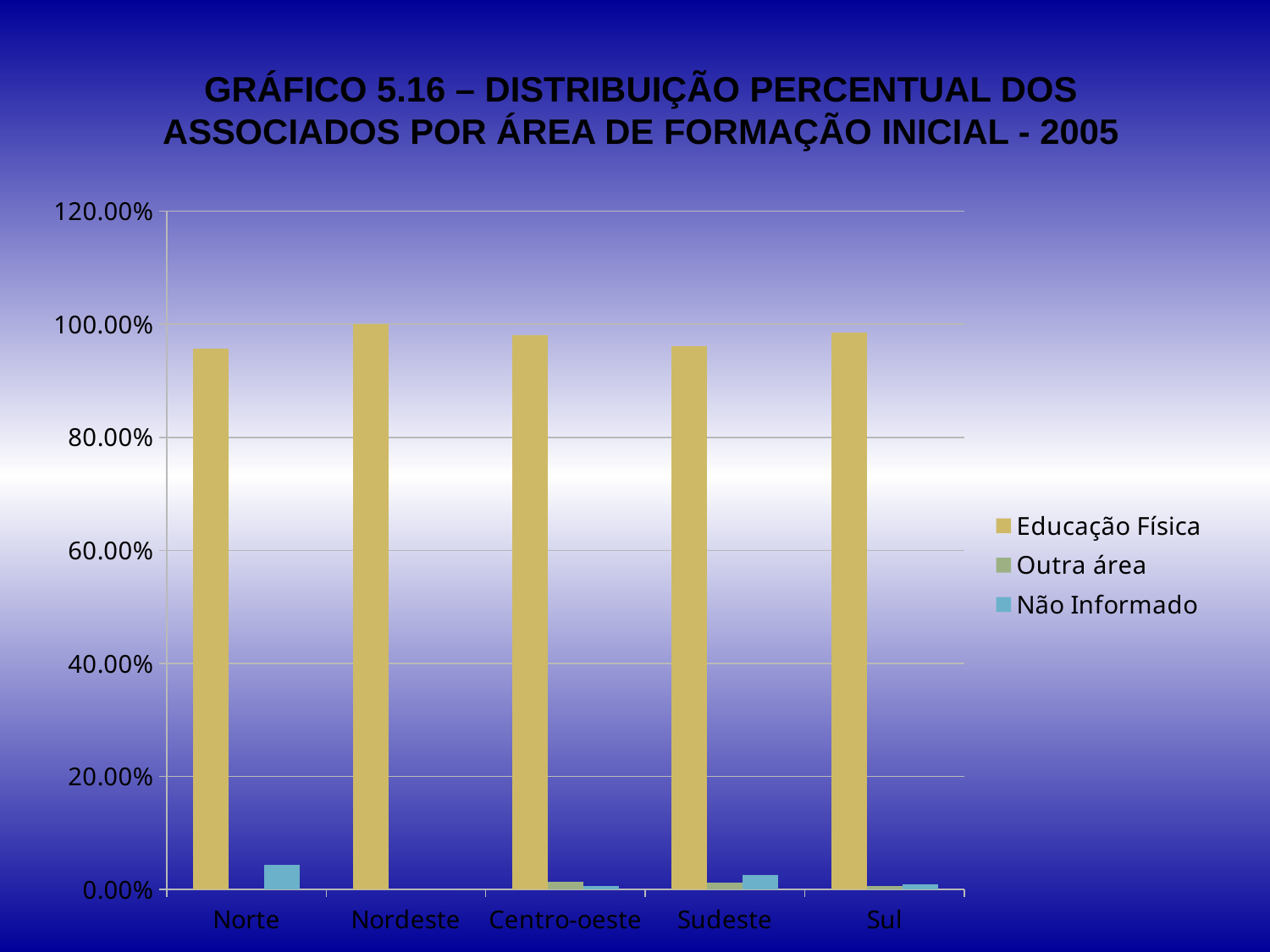
Which region has the highest value for Não Informado? Norte What are the three series listed in the legend? Educação Física, Outra área, Não Informado Is the value for Educação Física in Sudeste greater or less than 60.00%? greater How many regions (categories) are shown on the x axis? 5 Which region has the highest value for Educação Física? Nordeste How many series does the legend list? 3 What kind of chart is shown on the slide? Bar chart What year does the chart title refer to? 2005 Which is larger: the Educação Física value for Nordeste or for Norte? Nordeste Which is larger: the Não Informado value for Norte or for Sudeste? Norte Is the value for Educação Física in Norte greater or less than 80.00%? greater Is the value for Não Informado in Norte greater or less than 20.00%? less